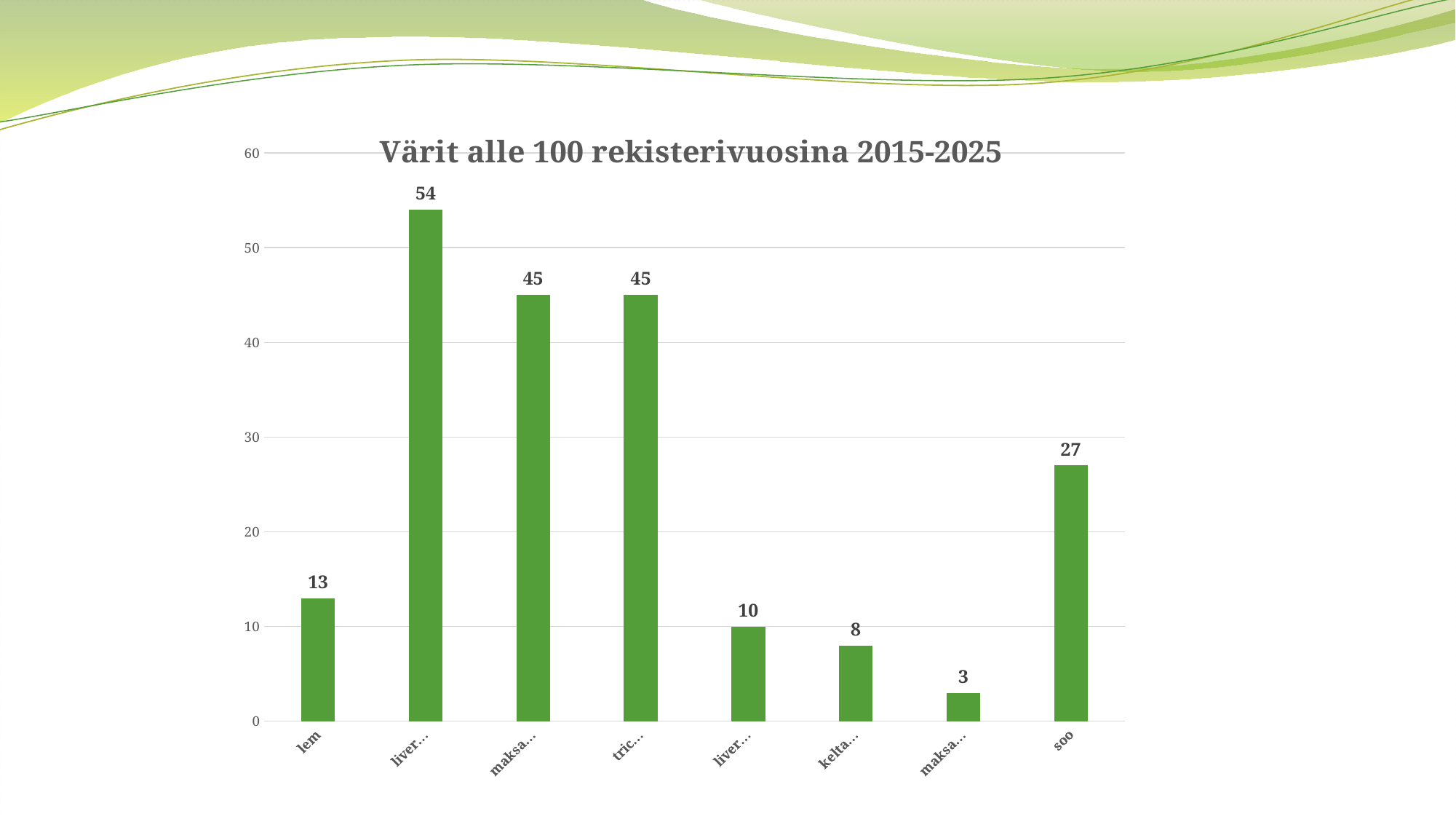
What is the value of the seventh bar from the left? 3 What kind of chart is shown on the slide? bar chart How many bars are shown in the chart? 8 What is the maximum value shown on the vertical axis? 60 What is the lowest value shown in the chart? 3 What is the highest value shown in the chart? 54 What is the value for soo? 27 Which has a larger value, lem or soo? soo What is the value for lem? 13 What is the difference between the values for soo and lem? 14 What is the title of the chart? Värit alle 100 rekisterivuosina 2015-2025 What is the value of the second bar from the left? 54